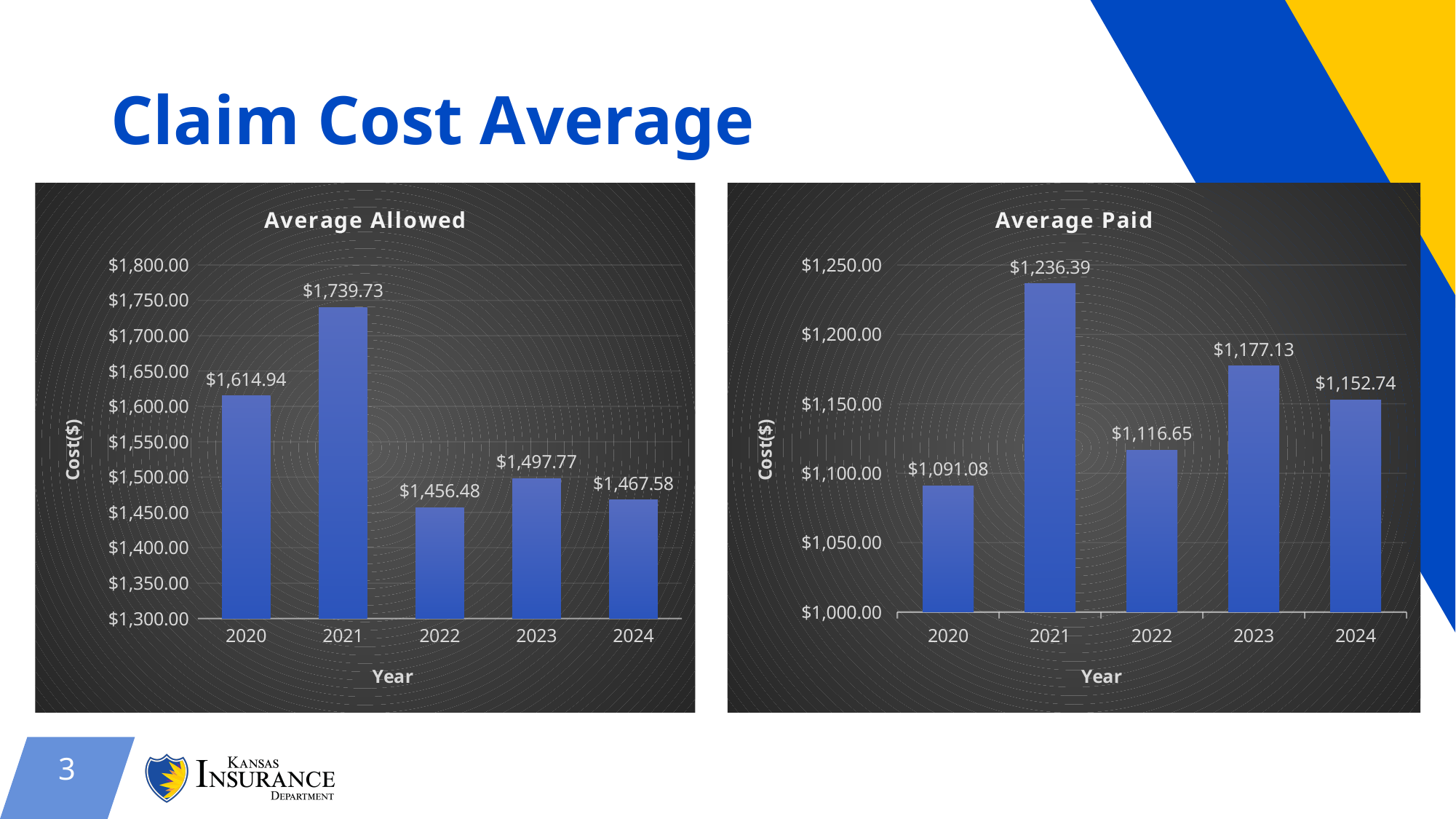
In the Average Paid chart, do the values rise or fall from 2023 to 2024? fall In the Average Paid chart, what is the value for 2020? $1,091.08 In the Average Allowed chart, which is larger, the value for 2023 or the value for 2024? 2023 What kind of chart is the Average Allowed chart? bar chart In the Average Paid chart, which year has the highest value? 2021 In the Average Allowed chart, what is the difference between the 2021 and 2020 values? $124.79 In the Average Paid chart, is the value for 2024 greater or less than $1,150.00? greater In the Average Allowed chart, which year has the lowest value? 2022 What is the label on the y axis of the Average Allowed chart? Cost($) In the Average Allowed chart, what is the value for 2021? $1,739.73 In the Average Paid chart, what is the difference between the 2023 and 2022 values? $60.48 How many years are shown in the Average Paid chart? 5